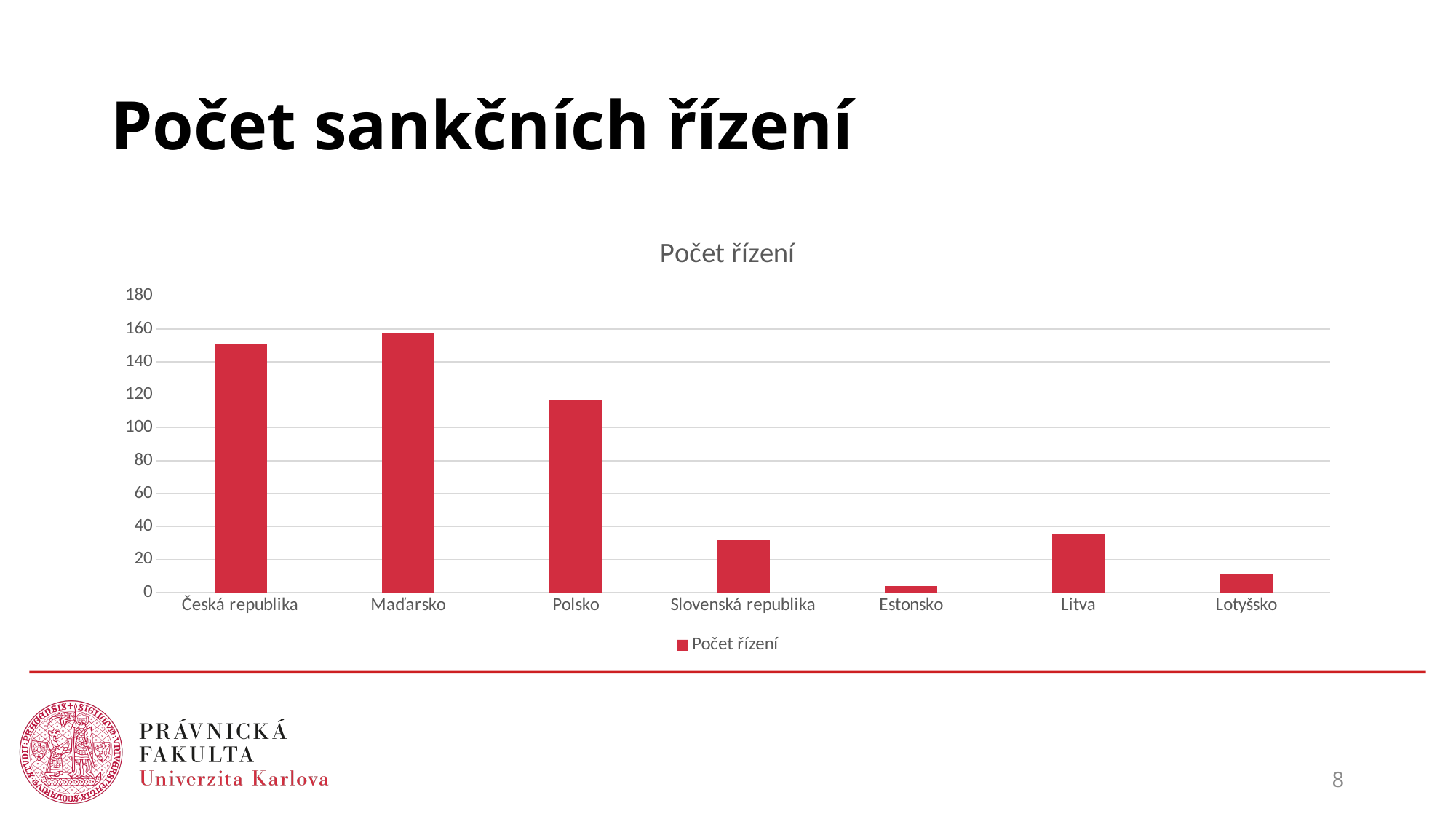
Is the value for Česká republika greater or less than 140? greater Is the value for Slovenská republika greater or less than 40? less Which is larger, the value for Lotyšsko or the value for Estonsko? Lotyšsko What is the title of the chart? Počet řízení Is the value for Polsko greater or less than 100? greater Which country has the lowest value in the chart? Estonsko How many countries are shown on the x axis of the chart? 7 What kind of chart is shown on the slide? bar chart Which is larger, the value for Polsko or the value for Slovenská republika? Polsko How many series does the chart legend list? 1